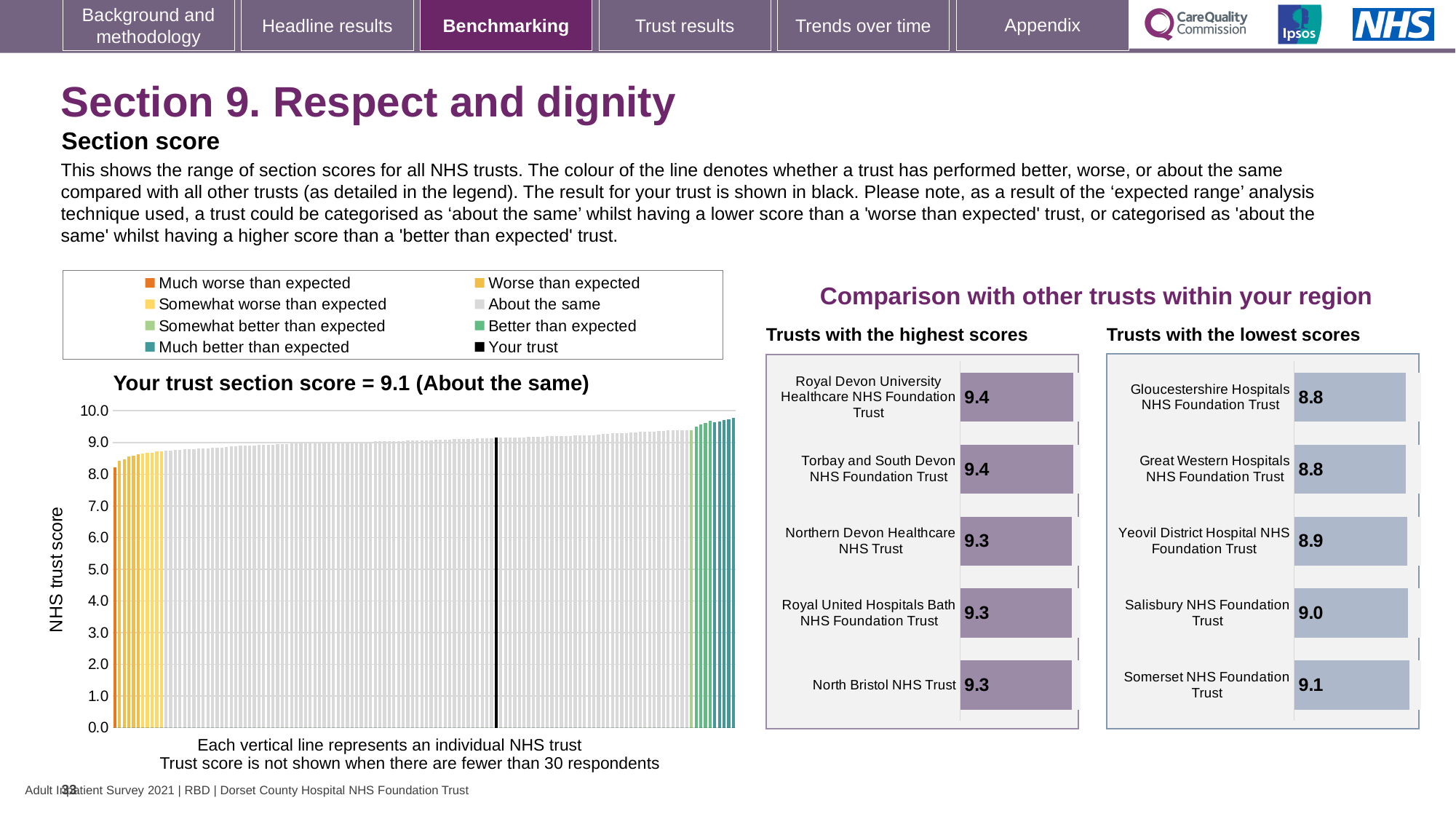
In the 'Trusts with the lowest scores' chart, which trust has the highest score? Somerset NHS Foundation Trust How many entries does the legend above the 'Your trust section score' chart list? 8 What is the y-axis label of the 'Your trust section score' chart? NHS trust score In the 'Trusts with the highest scores' chart, what is the score for Torbay and South Devon NHS Foundation Trust? 9.4 In the 'Trusts with the highest scores' chart, what is the score for Northern Devon Healthcare NHS Trust? 9.3 In the 'Trusts with the lowest scores' chart, which has the larger score: Yeovil District Hospital NHS Foundation Trust or Salisbury NHS Foundation Trust? Salisbury NHS Foundation Trust How many trusts are shown in the 'Trusts with the highest scores' chart? 5 In the 'Your trust section score' chart, do the bar values rise or fall from left to right? rise In the 'Your trust section score' chart, what is the section score for your trust? 9.1 In the 'Trusts with the lowest scores' chart, what is the difference between the scores of Somerset NHS Foundation Trust and Gloucestershire Hospitals NHS Foundation Trust? 0.3 In the 'Your trust section score' chart, is the value of the leftmost (lowest) bar greater or less than 9.0? less What kind of chart is the 'Your trust section score' chart? bar chart